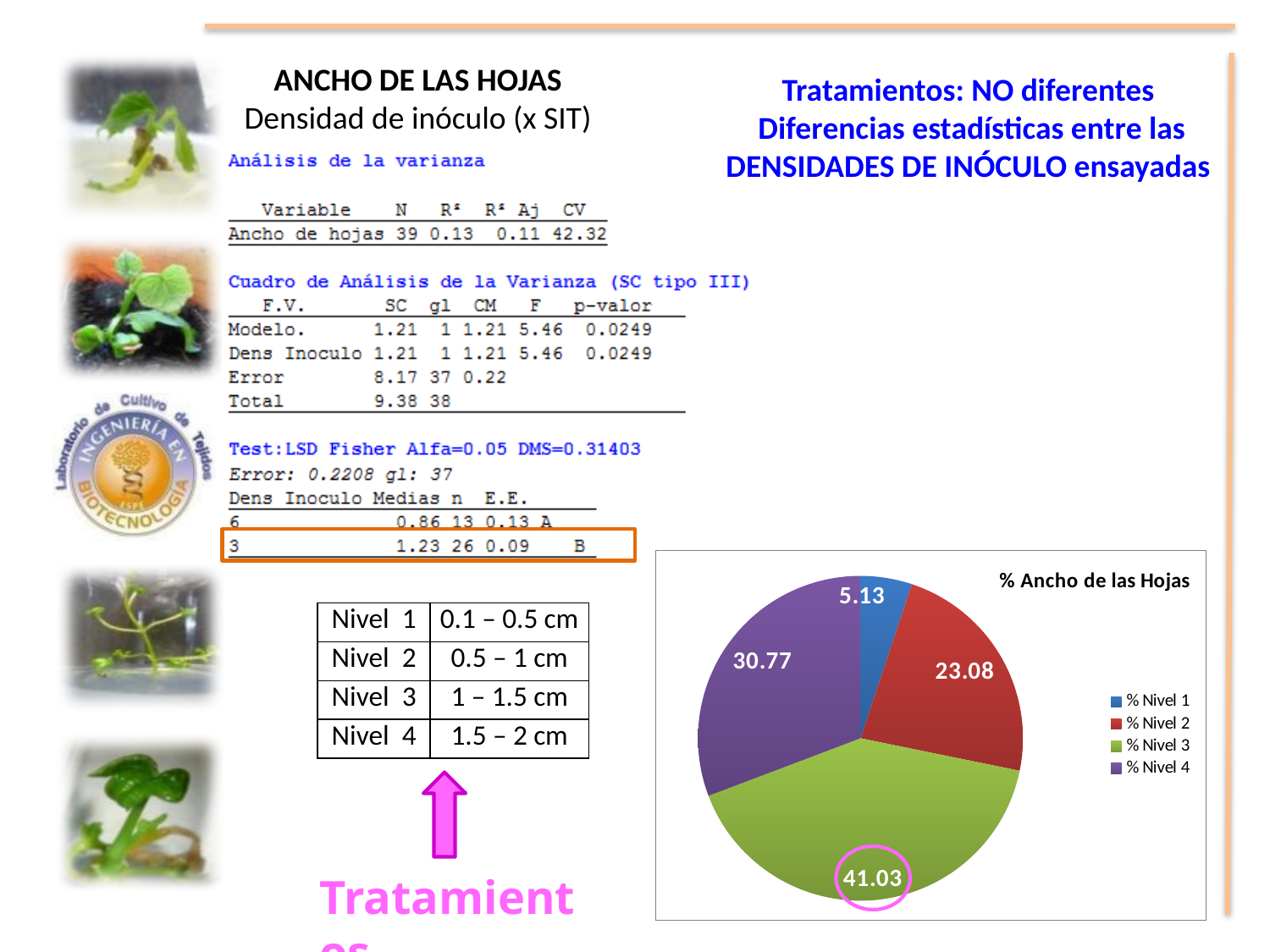
What is the difference between the values for % Nivel 3 and % Nivel 4 in the pie chart? 10.26 How many slices does the pie chart have? 4 What is the value for % Nivel 2 in the pie chart? 23.08 How many entries does the legend of the pie chart list? 4 What is the value for % Nivel 1 in the pie chart? 5.13 What is the title of the pie chart? % Ancho de las Hojas Which category has the smallest slice in the pie chart? % Nivel 1 Which is larger in the pie chart, % Nivel 2 or % Nivel 4? % Nivel 4 Which category has the largest slice in the pie chart? % Nivel 3 What is the value for % Nivel 3 in the pie chart? 41.03 What kind of chart is shown on the slide? pie chart What is the value for % Nivel 4 in the pie chart? 30.77